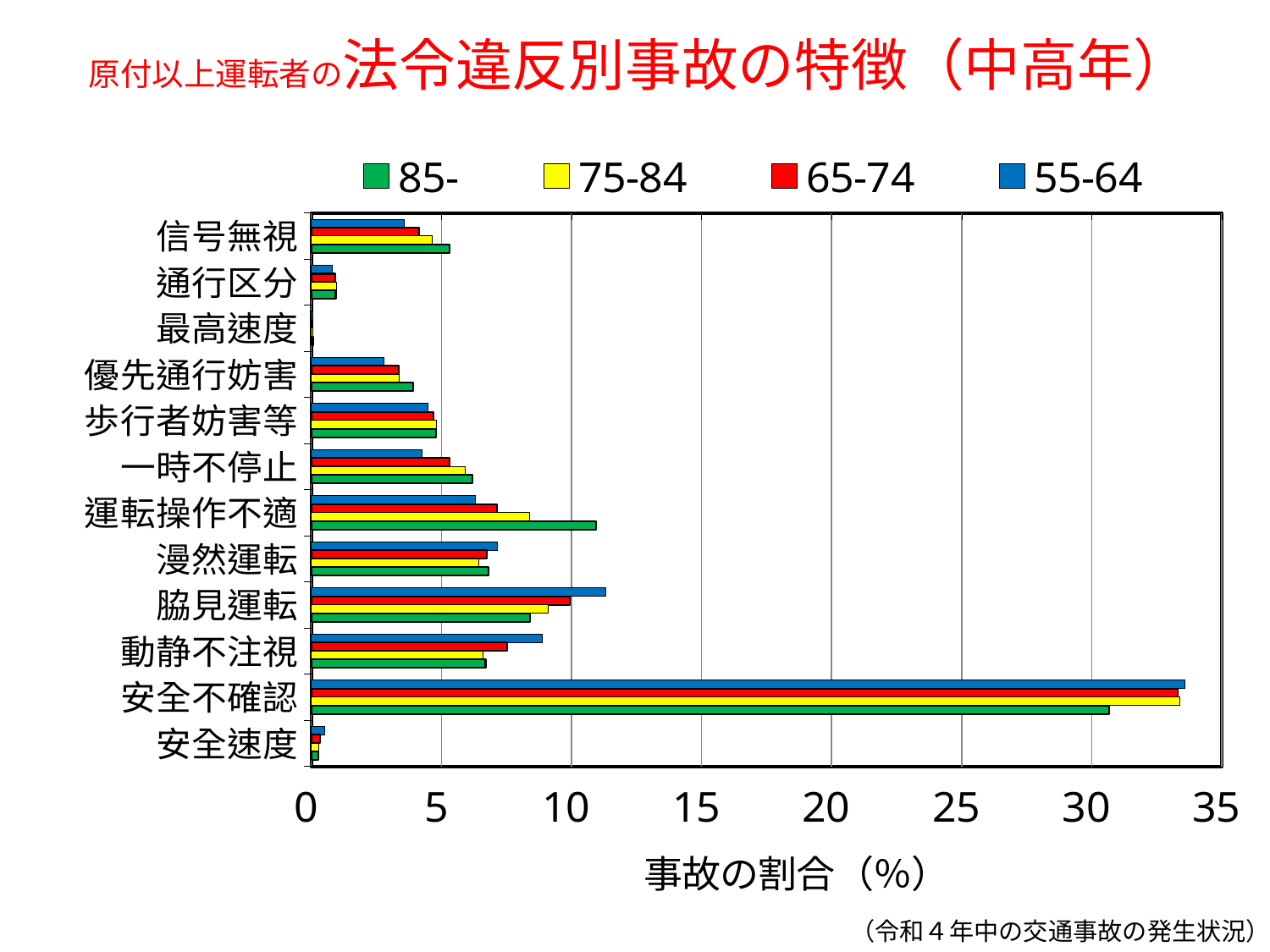
For 運転操作不適, which series has the larger value: 85- or 55-64? 85- Which category has the lowest values across all series? 最高速度 Which category has the highest value for the 55-64 series? 安全不確認 What kind of chart is shown on the slide? bar chart How many violation categories are shown on the vertical axis? 12 Is the value for 安全不確認 in the 85- series greater or less than 25? greater What is the title of the horizontal axis? 事故の割合（%） Is the value for 安全不確認 in the 55-64 series greater or less than 30? greater Is the value for 脇見運転 in the 55-64 series greater or less than 10? greater How many series does the legend list? 4 For 脇見運転, which series has the larger value: 55-64 or 85-? 55-64